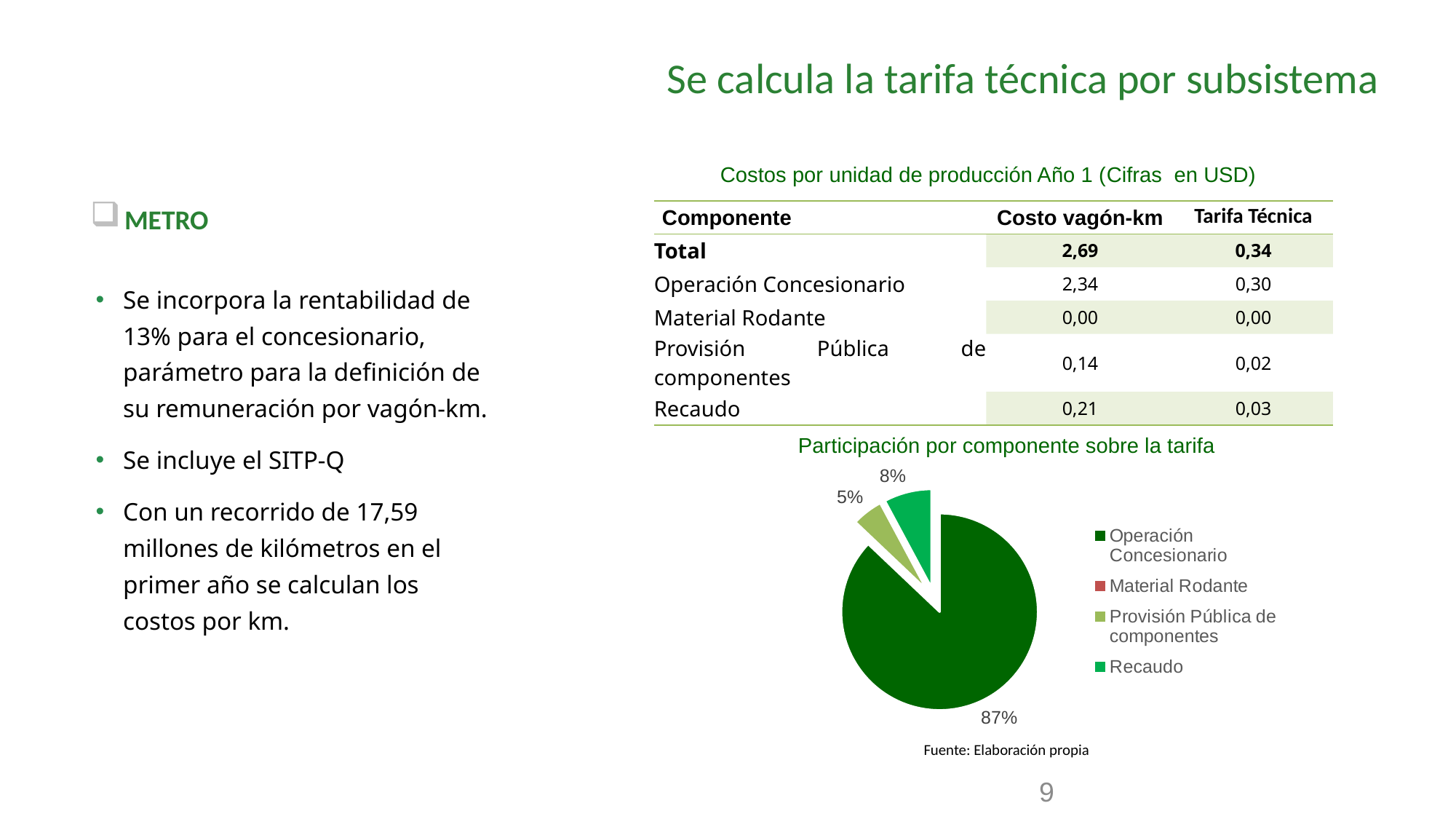
What share of the pie does Provisión Pública de componentes represent? 5% How many slices of the pie have a percentage label printed on the chart? 3 What is the difference in percentage points between the Operación Concesionario slice and the Recaudo slice? 79 Which legend entry is shown in red in the chart's legend? Material Rodante What share of the pie does Recaudo represent? 8% Which of the two, Recaudo or Provisión Pública de componentes, has the larger share of the pie? Recaudo What share of the pie does Operación Concesionario represent? 87% Which component has the largest slice of the pie? Operación Concesionario What kind of chart is shown on the slide? pie chart How many entries does the chart's legend list? 4 What is the title of the chart on the slide? Participación por componente sobre la tarifa What is the difference in percentage points between the Recaudo slice and the Provisión Pública de componentes slice? 3